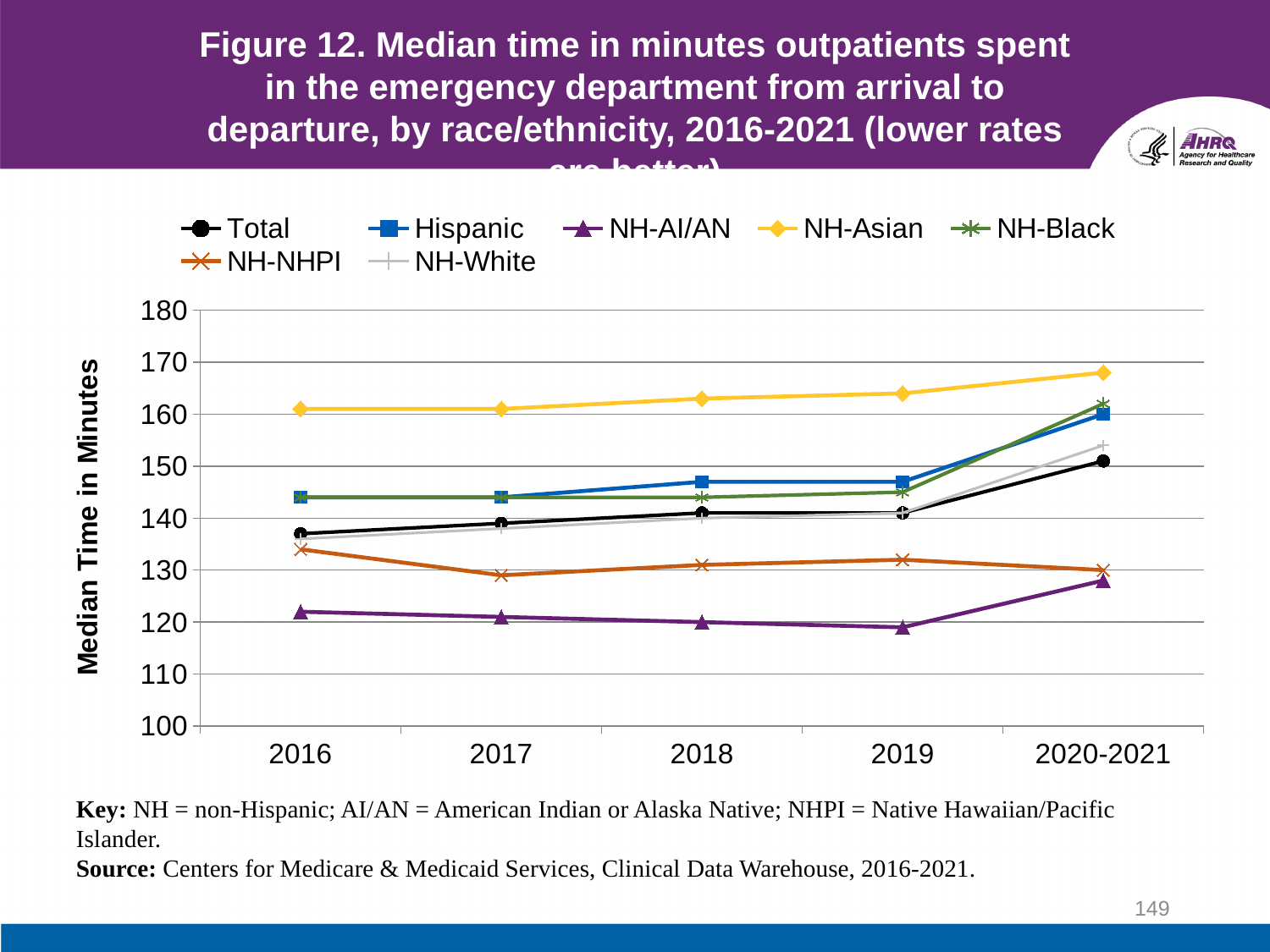
How many time points are shown on the x axis? 5 Does the median time for NH-Asian rise or fall from 2016 to 2020-2021? rise Is the value for NH-Asian in 2020-2021 greater or less than 160? greater Is the value for NH-White in 2020-2021 greater or less than 150? greater Is the value for Total in 2016 greater or less than 140? less Which race/ethnicity group has the highest median time in 2020-2021? NH-Asian What kind of chart is shown on the slide? line chart In 2019, which is larger: the median time for NH-Asian or for Total? NH-Asian How many series does the legend list? 7 Which group has the highest median time in 2018? NH-Asian Which race/ethnicity group has the lowest median time in 2016? NH-AI/AN